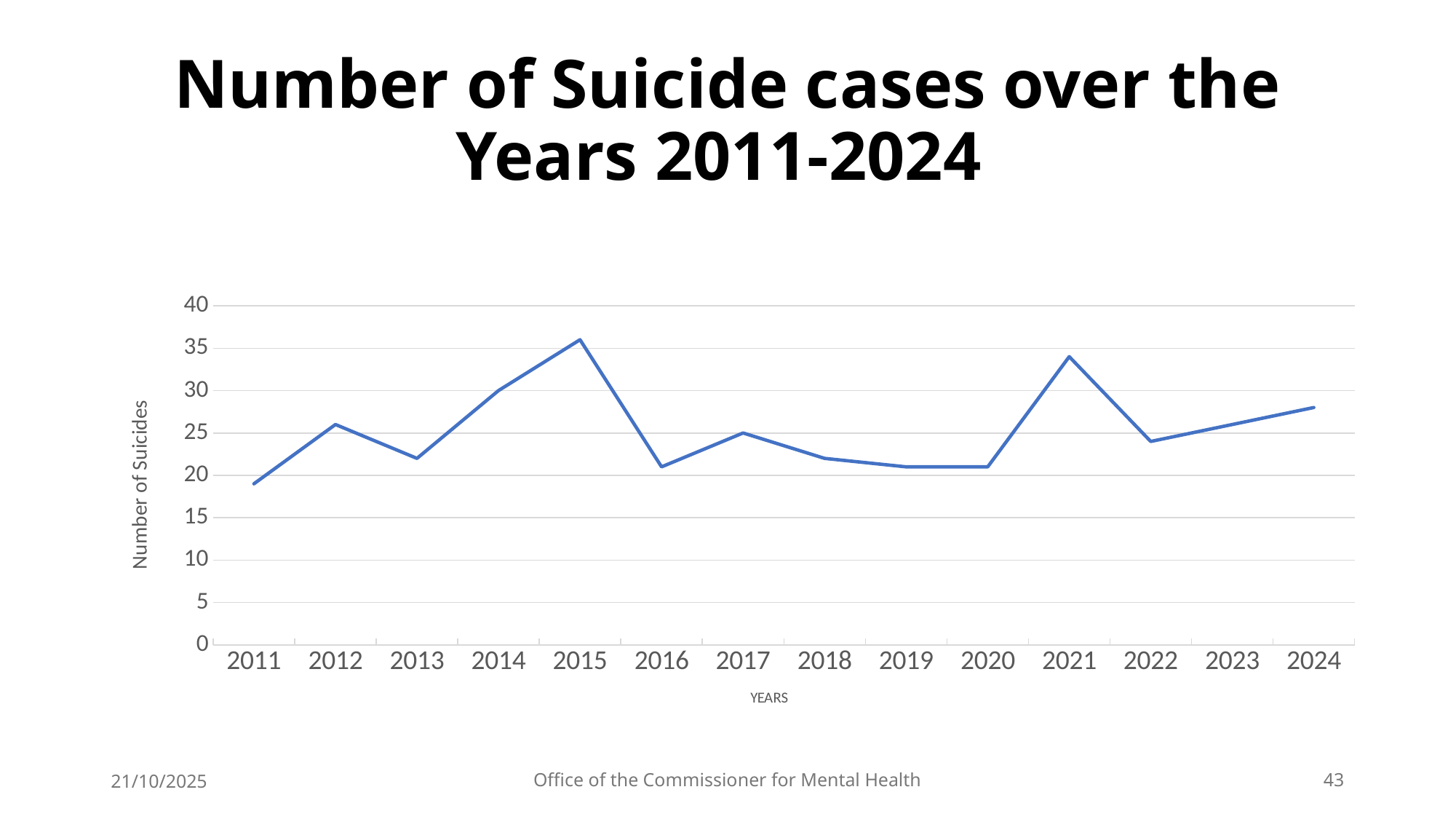
What is the label of the vertical axis? Number of Suicides Which year has the larger number of suicides, 2015 or 2021? 2015 Which year has the highest number of suicides? 2015 What is the title of the chart? Number of Suicide cases over the Years 2011-2024 Is the value for 2011 greater or less than 20? less Is the value for 2021 greater or less than 30? greater Do the values rise or fall from 2022 to 2024? rise What type of chart is shown on the slide? Line chart Is the value for 2015 greater or less than 30? greater Which year has the lowest number of suicides? 2011 How many years are plotted on the x axis? 14